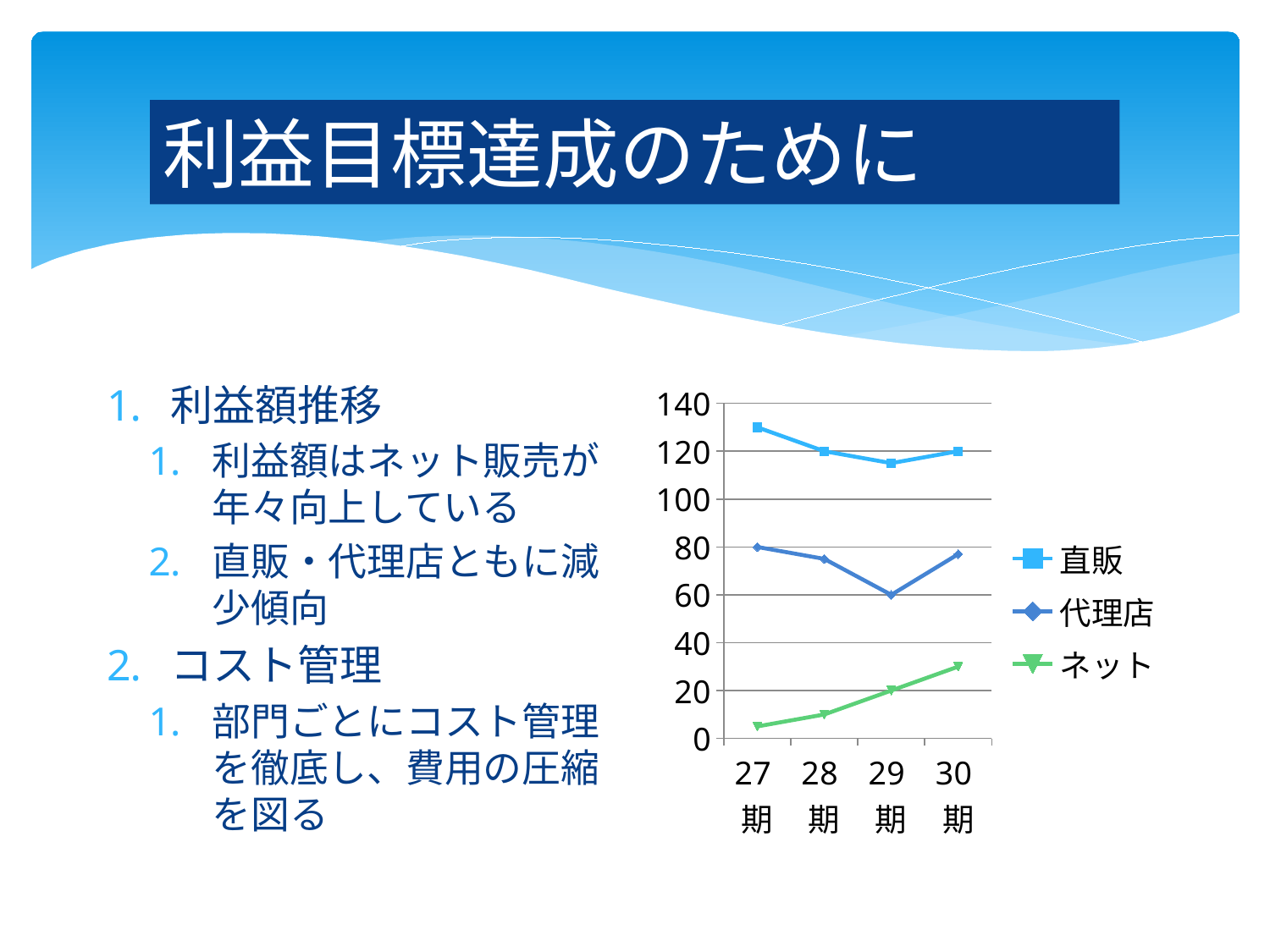
Is the value for ネット in 27期 greater or less than 20? less How many series does the chart legend list? 3 Does the ネット series rise or fall from 27期 to 30期? rise Which series has the highest values across all periods? 直販 What is the value for ネット in 29期? 20 What is the value for 代理店 in 29期? 60 How many periods are plotted along the x axis of the chart? 4 What is the value for 直販 in 28期? 120 What kind of chart is shown on the slide? line chart Which is larger in 29期, the value for 代理店 or the value for ネット? 代理店 Is the value for 直販 in 27期 greater or less than 120? greater What is the value for 代理店 in 27期? 80